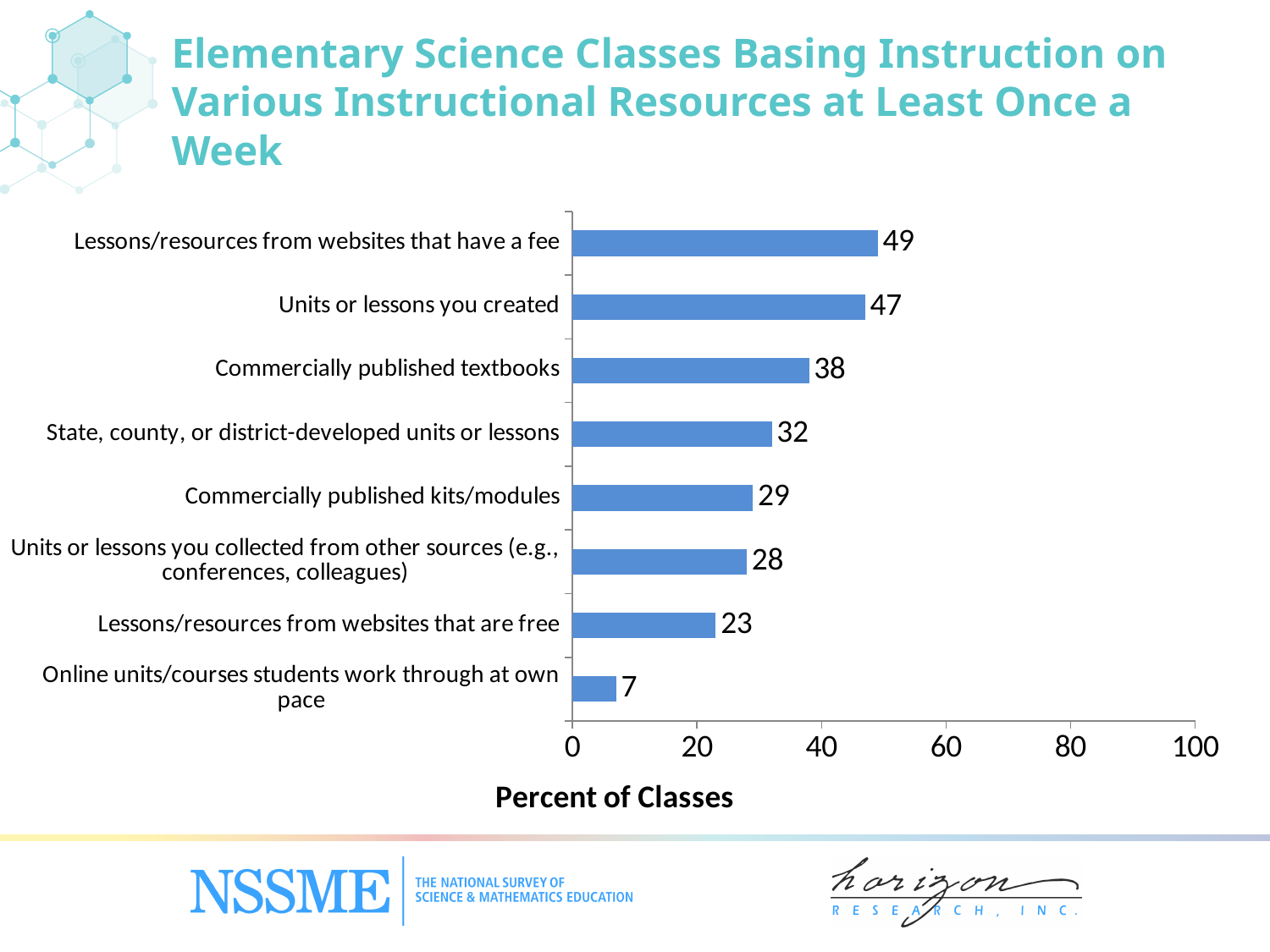
How many instructional resource categories are shown in the chart? 8 Which instructional resource has the lowest percent of classes? Online units/courses students work through at own pace What is the value for 'Lessons/resources from websites that are free'? 23 What is the value for 'Online units/courses students work through at own pace'? 7 Which is larger: the value for 'State, county, or district-developed units or lessons' or the value for 'Lessons/resources from websites that are free'? State, county, or district-developed units or lessons Is the value for 'Commercially published kits/modules' greater or less than 40? less What kind of chart is shown on the slide? Bar chart What is the difference between the values for 'Units or lessons you created' and 'Commercially published kits/modules'? 18 What is the maximum value shown on the horizontal axis? 100 What is the label of the horizontal axis? Percent of Classes Which instructional resource has the highest percent of classes? Lessons/resources from websites that have a fee What percent of classes base instruction on commercially published textbooks at least once a week? 38